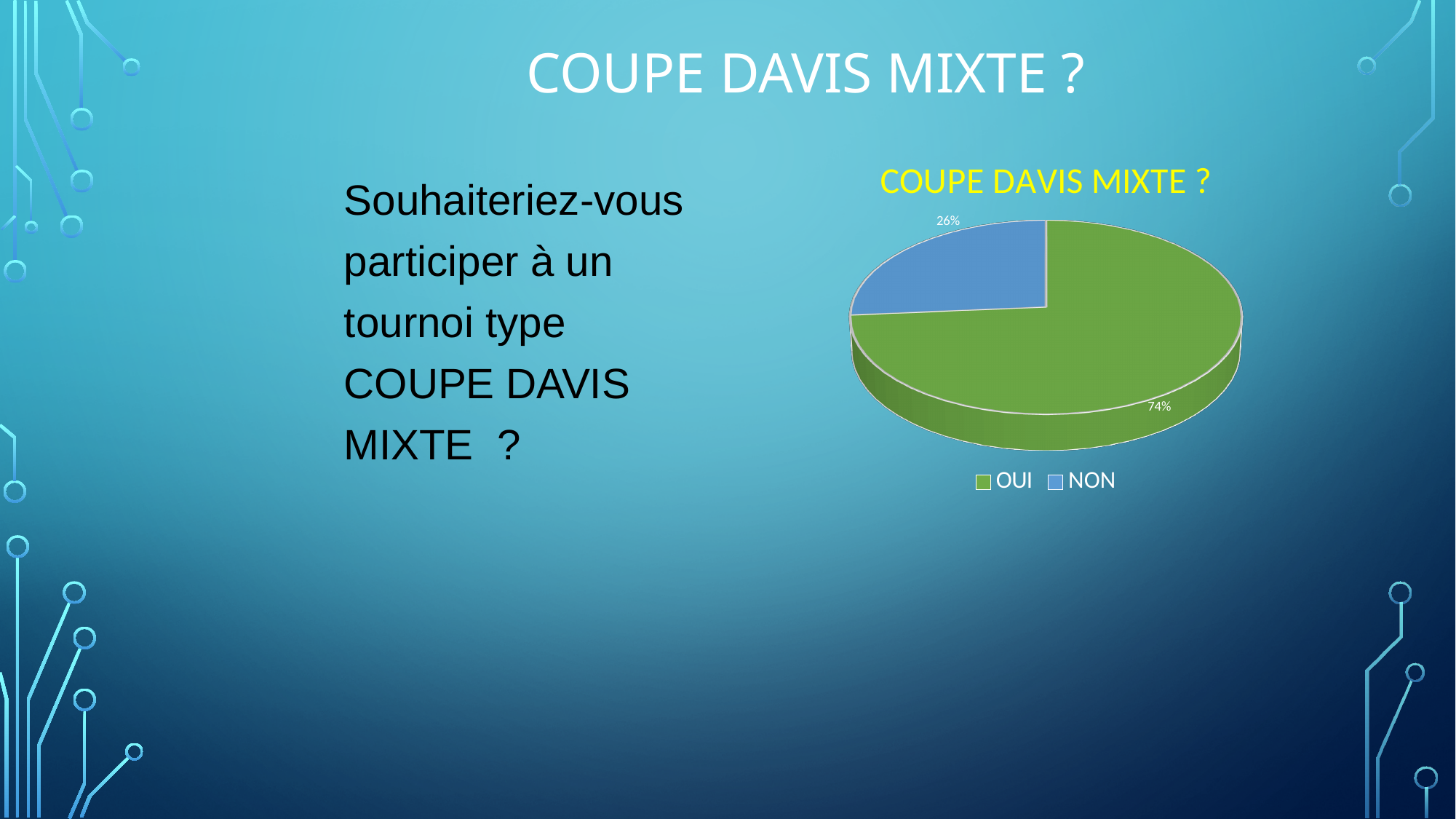
How many entries does the legend list? 2 Which slice is the largest? OUI What is the title of the chart? COUPE DAVIS MIXTE ? What share of the pie does the NON slice represent? 26% What colour is the OUI slice? Green What is the difference in percentage points between the OUI and NON slices? 48 What percentage of the pie is labelled NON? 26% Which slice is the smallest? NON What kind of chart is shown on the slide? Pie chart How many slices does the pie chart have? 2 Which is larger, the OUI slice or the NON slice? OUI What percentage of the pie is labelled OUI? 74%